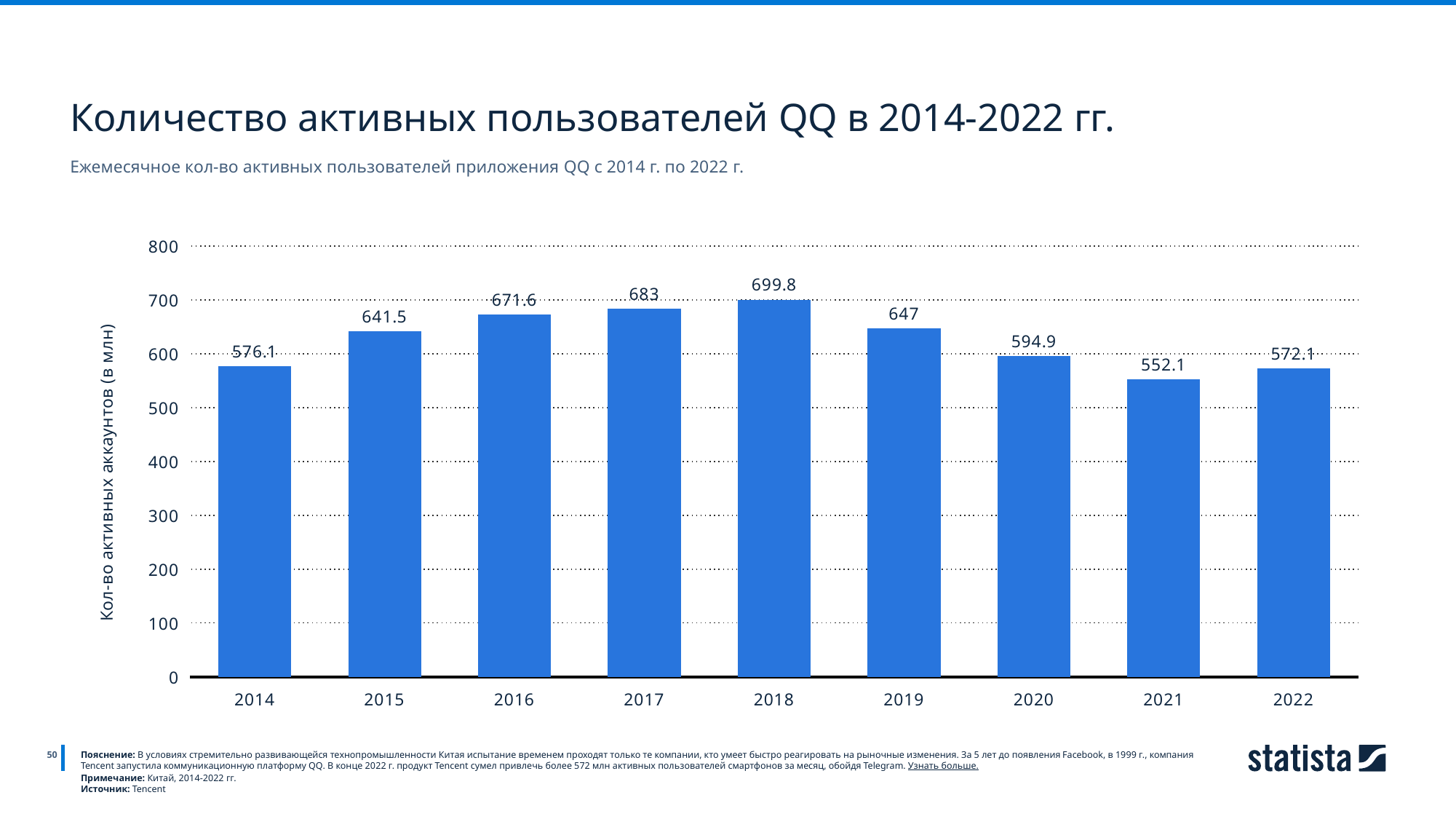
What kind of chart is this? bar chart What is the value for 2014? 576.1 Which year has the lowest value? 2021 What is the value for 2018? 699.8 Which is larger, the value for 2019 or the value for 2020? 2019 What is the difference between the values for 2017 and 2016? 11.4 What is the value for 2021? 552.1 What is the difference between the values for 2018 and 2021? 147.7 Which year has the highest value? 2018 Do the values rise or fall from 2018 to 2021? fall Is the value for 2022 greater or less than 600? less How many years are shown on the x axis? 9